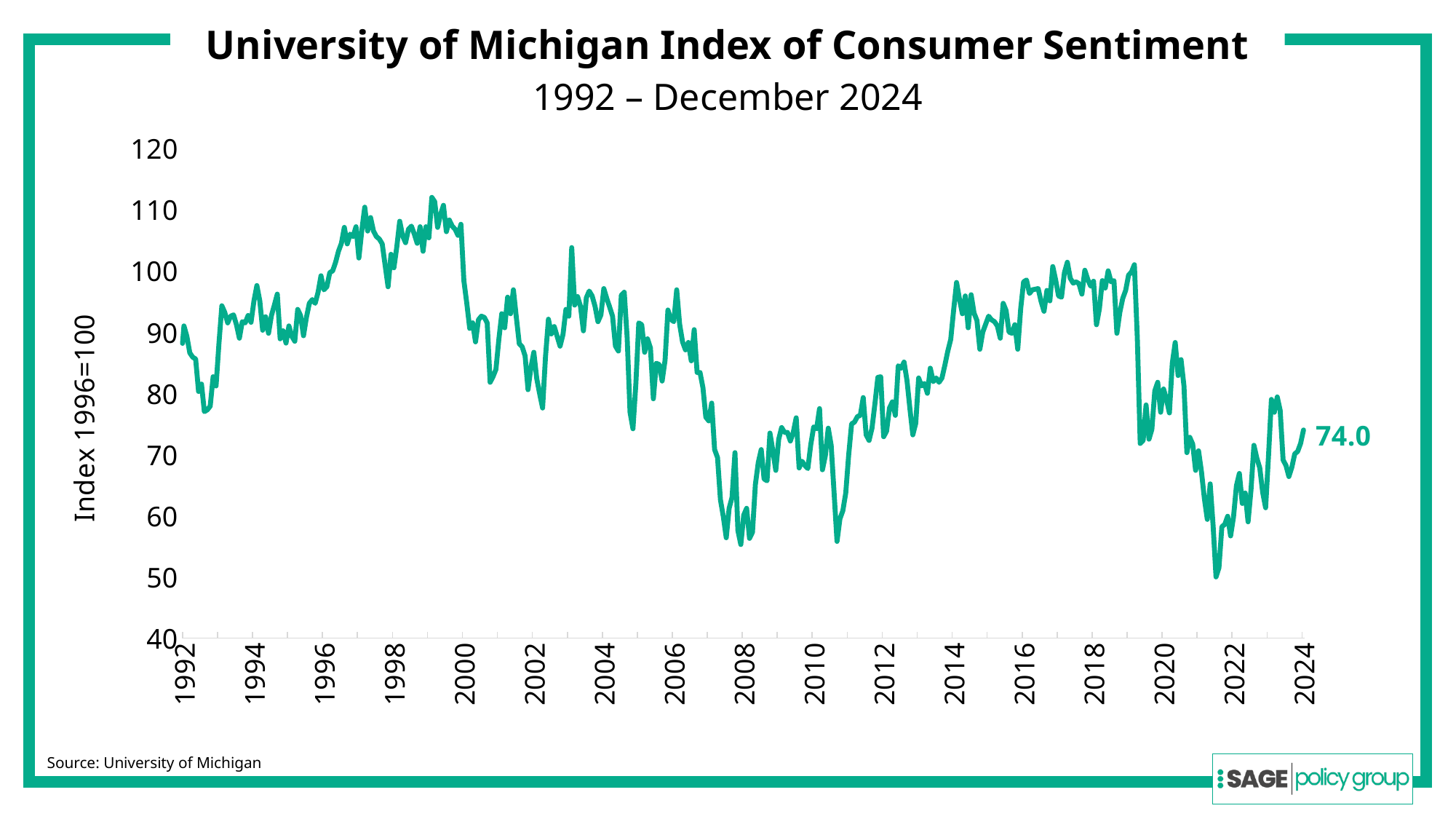
What is the title of the chart? University of Michigan Index of Consumer Sentiment Is the value of the index in 2018 greater or less than 90? greater Around which year does the index reach its lowest value? 2022 Is the value of the index at its peak around 2000 greater or less than 100? greater Around which year does the index reach its highest value? 2000 What is the label on the vertical axis? Index 1996=100 What is the value of the index shown by the data label at the end of the line, for December 2024? 74.0 Is the value of the index at its lowest point in 2022 greater or less than 60? less What kind of chart is shown on the slide? line chart Does the index rise or fall between 2019 and 2022? fall Which is higher, the index around 2000 or the index around 2022? 2000